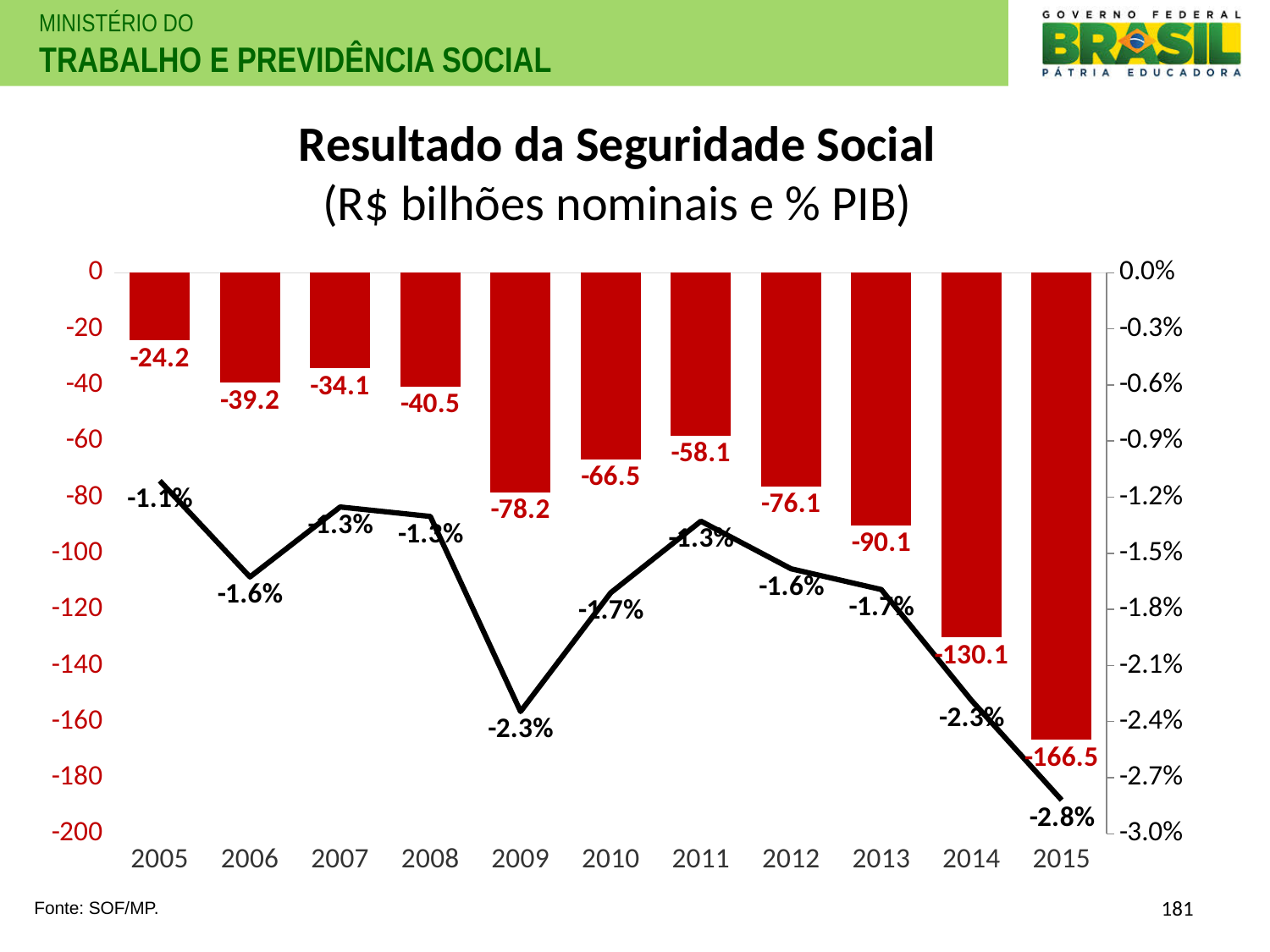
What is the title of the chart? Resultado da Seguridade Social (R$ bilhões nominais e % PIB) How many years are shown on the x axis? 11 Which year has the bar closest to zero (the smallest deficit)? 2005 What percentage of PIB is shown on the line for 2009? -2.3% Which year has the largest negative bar value (the lowest bar)? 2015 What percentage of PIB is shown on the line for 2015? -2.8% What kind of chart is this? Combined bar and line chart Which year has the larger deficit in R$ bilhões, 2010 or 2011? 2010 What is the value of the bar for 2005? -24.2 What is the value of the bar for 2015? -166.5 What is the difference between the bar values for 2015 and 2014? 36.4 What is the value of the bar for 2009? -78.2